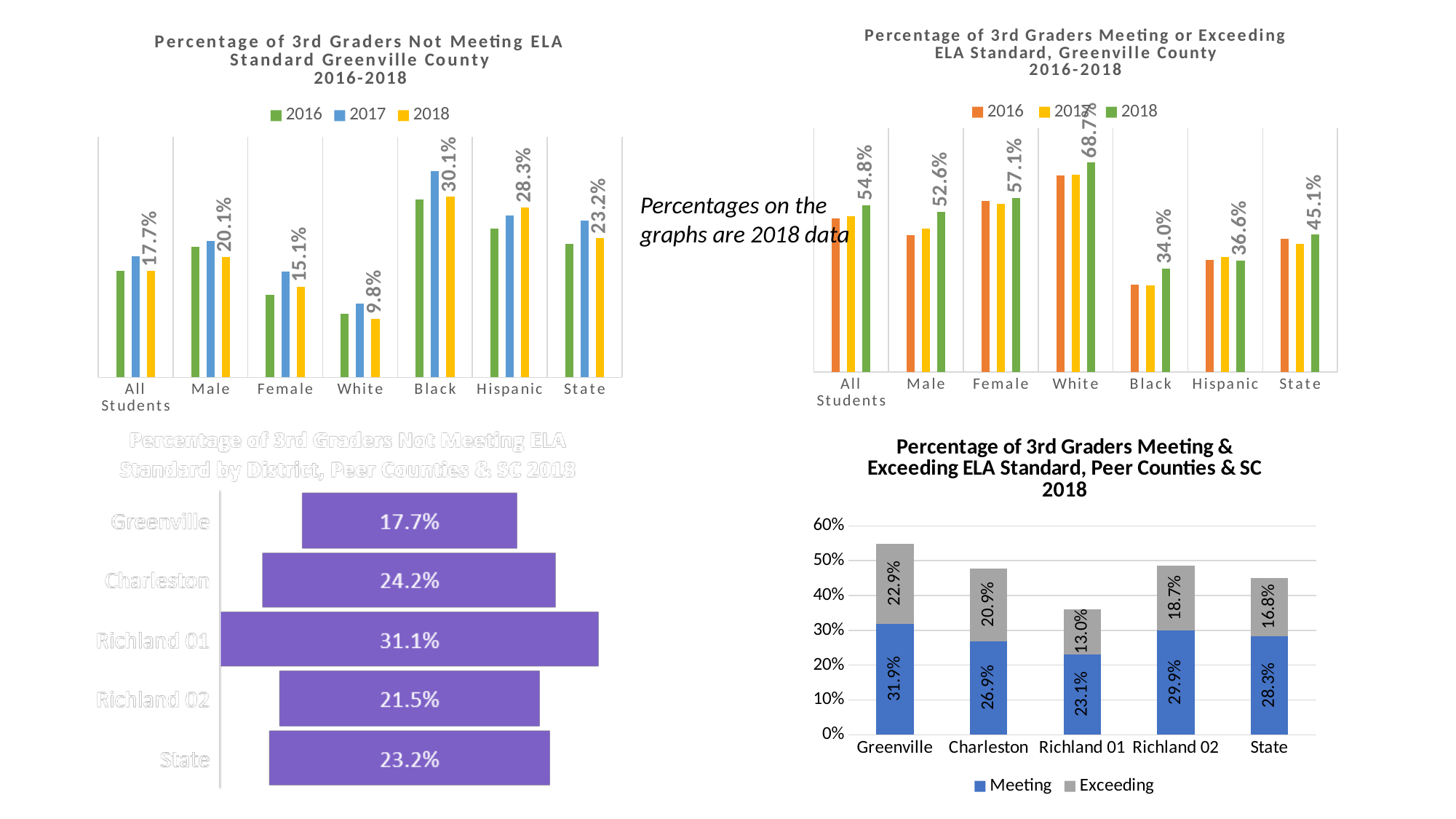
In the bottom-right chart (Meeting & Exceeding ELA Standard, Peer Counties & SC 2018), which district has the lowest Meeting value? Richland 01 In the bottom-left chart (Not Meeting ELA Standard by District), what is the difference between Charleston and Greenville? 6.5% In the top-left chart (Not Meeting ELA Standard, Greenville County 2016-2018), which category has the highest 2018 value? Black In the bottom-right chart (Meeting & Exceeding ELA Standard, Peer Counties & SC 2018), what is the Exceeding value for Richland 02? 18.7% In the top-left chart (Not Meeting ELA Standard, Greenville County 2016-2018), what is the 2018 value for White students? 9.8% In the bottom-left chart (Not Meeting ELA Standard by District), which district has the lowest percentage? Greenville In the bottom-right chart (Meeting & Exceeding ELA Standard, Peer Counties & SC 2018), how many series does the legend list? 2 In the bottom-left chart (Not Meeting ELA Standard by District), what is the value for Richland 01? 31.1% In the top-right chart (Meeting or Exceeding ELA Standard, Greenville County 2016-2018), how many categories are shown on the x axis? 7 In the bottom-right chart (Meeting & Exceeding ELA Standard, Peer Counties & SC 2018), what is the total of the Greenville stacked bar? 54.8% In the top-right chart (Meeting or Exceeding ELA Standard, Greenville County 2016-2018), what is the 2018 value for Female students? 57.1% In the top-right chart (Meeting or Exceeding ELA Standard, Greenville County 2016-2018), is the 2018 value for White students larger or smaller than the 2018 value for Black students? larger